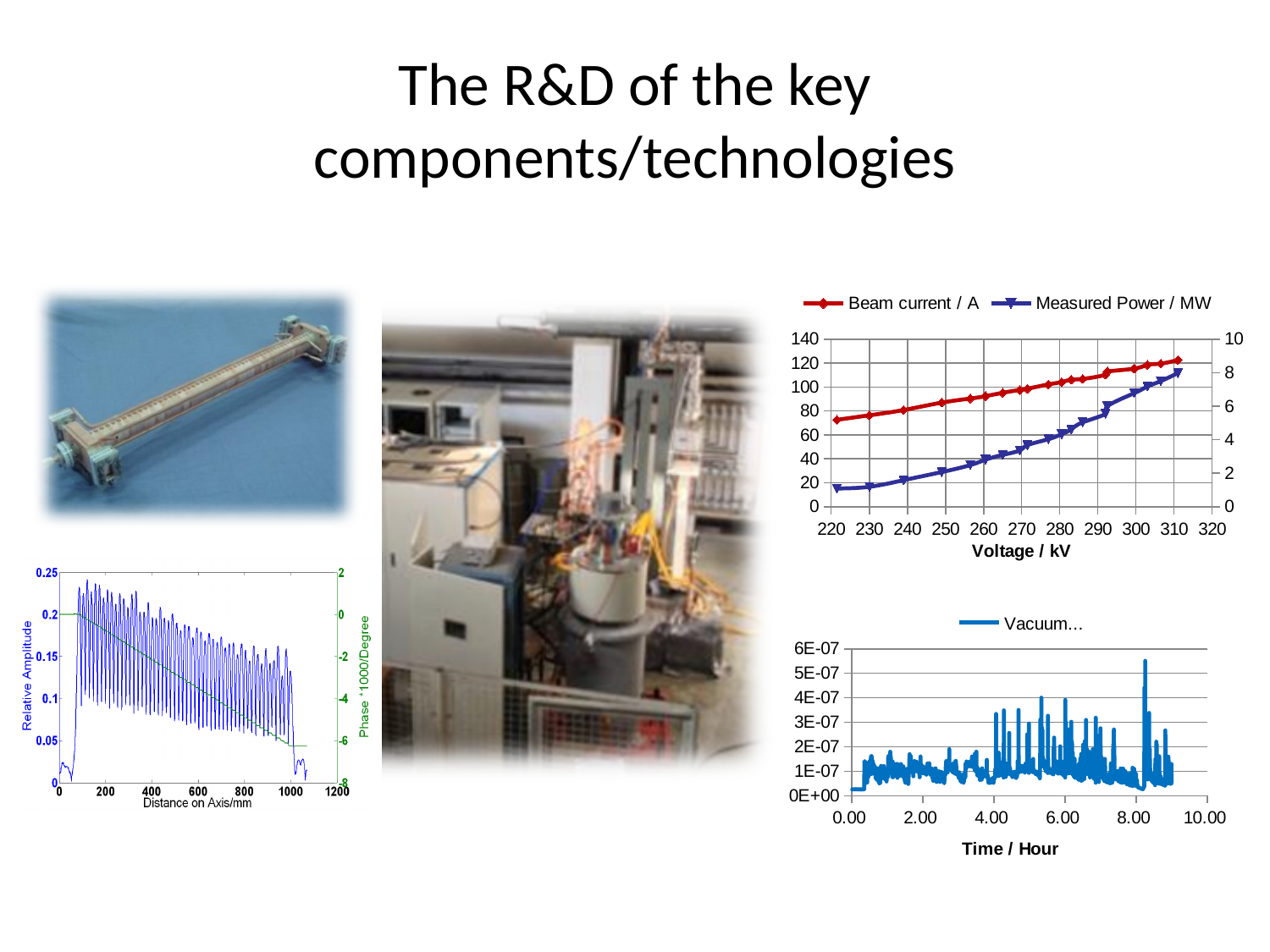
In the top-right chart, does the Measured Power / MW series rise or fall as Voltage increases? rise In the top-right chart, does the Beam current / A series rise or fall as Voltage increases? rise In the top-right chart, how many series does the legend list? 2 In the top-right chart, is the Beam current / A value at 220 kV greater or less than 60 on the left axis? greater In the bottom-right chart, what is the title of the x axis? Time / Hour In the top-right chart, is the Beam current / A value at 310 kV greater or less than 100 on the left axis? greater In the top-right chart, what is the title of the x axis? Voltage / kV What kind of chart is the top-right chart plotting Beam current and Measured Power against Voltage? line chart In the top-right chart, is the Measured Power / MW value at 310 kV greater or less than 6 on the right axis? greater In the bottom-left chart, does the Phase line (right axis) rise or fall as Distance on Axis increases? fall